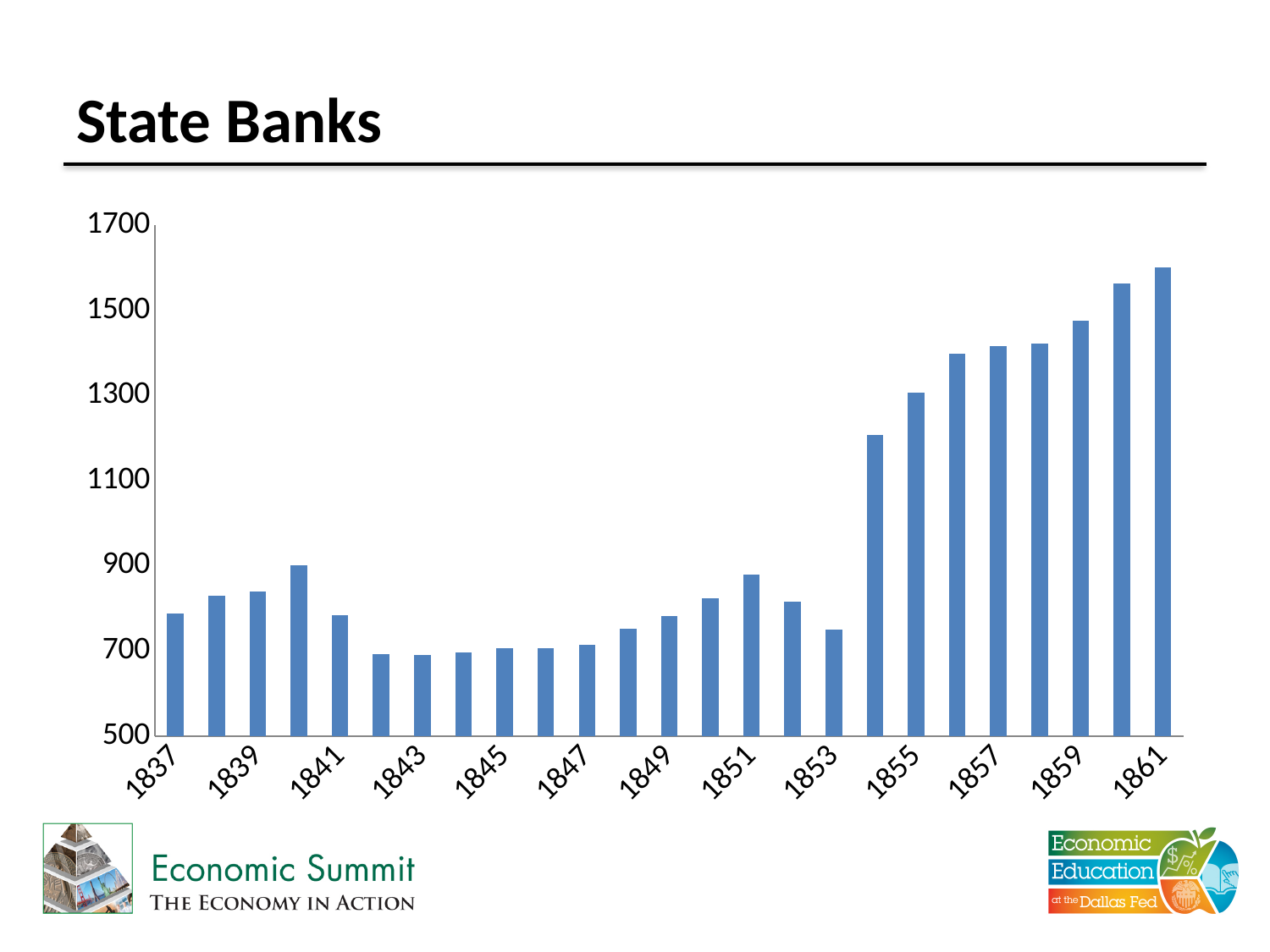
Do the values rise or fall from 1853 to 1861? rise What is the title of the chart? State Banks What kind of chart is shown on the slide? bar chart Is the value for 1857 greater or less than 1300? greater How many bars are plotted in the chart? 25 Is the value for 1855 greater or less than 1100? greater Which is larger, the value for 1853 or the value for 1855? 1855 Which year has the highest value in the chart? 1861 Which is larger, the value for 1837 or the value for 1861? 1861 Is the value for 1853 greater or less than 900? less